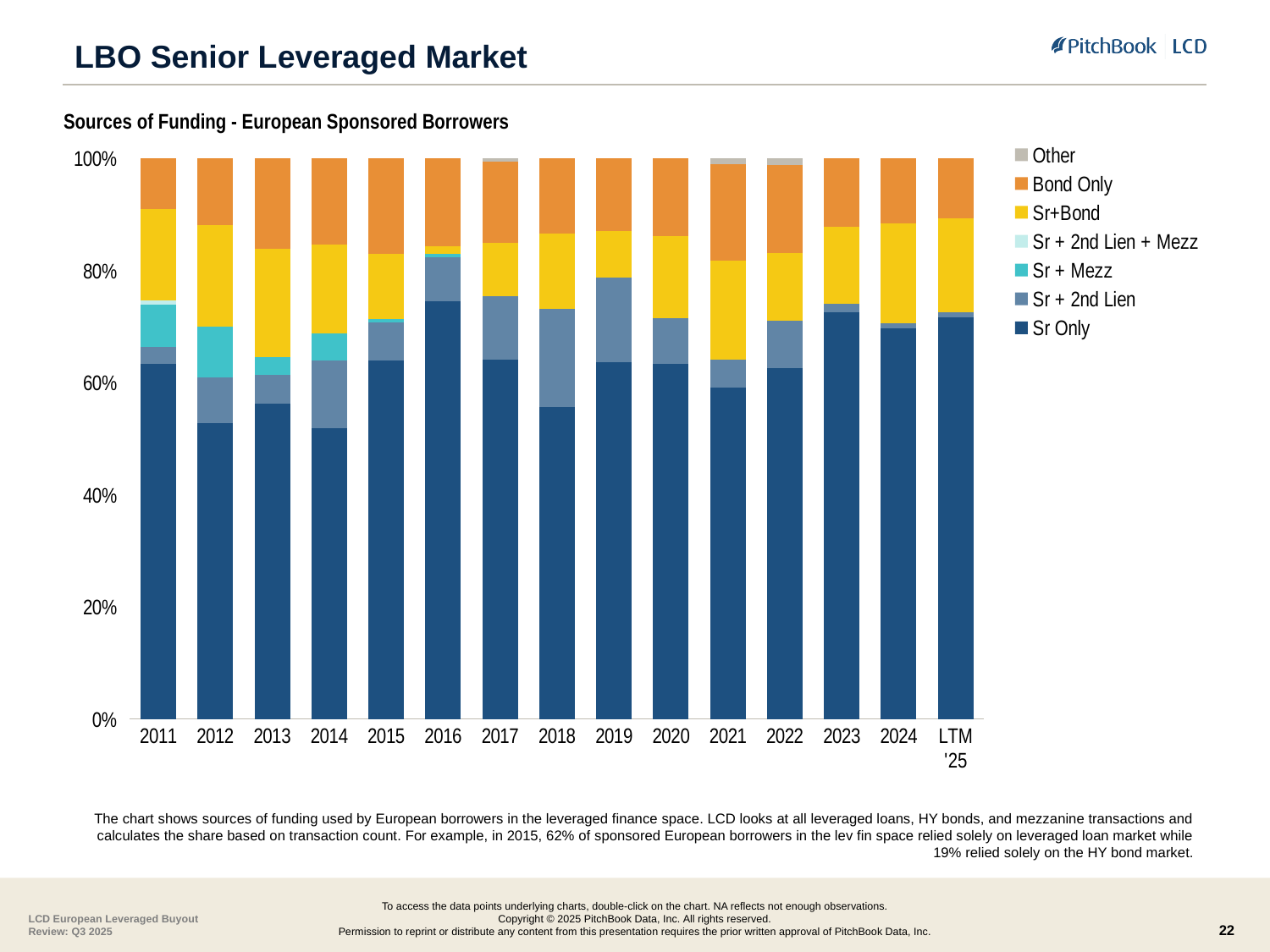
How many series does the legend list? 7 Which year has the larger Sr Only share, 2016 or 2018? 2016 Does the Sr Only share rise or fall from 2021 to 2023? rise Is the Sr Only share for 2018 greater or less than 60%? less What is the title of the chart? Sources of Funding - European Sponsored Borrowers In which year is the Sr + 2nd Lien segment the largest? 2018 What type of chart is shown on the slide? Stacked bar chart Is the Sr Only share for 2012 greater or less than 60%? less How many year categories are shown on the x axis? 15 Is the Sr Only share for 2016 greater or less than 70%? greater Which legend entry is listed first (at the top) in the legend? Other Which year has the larger Sr Only share, 2012 or 2023? 2023